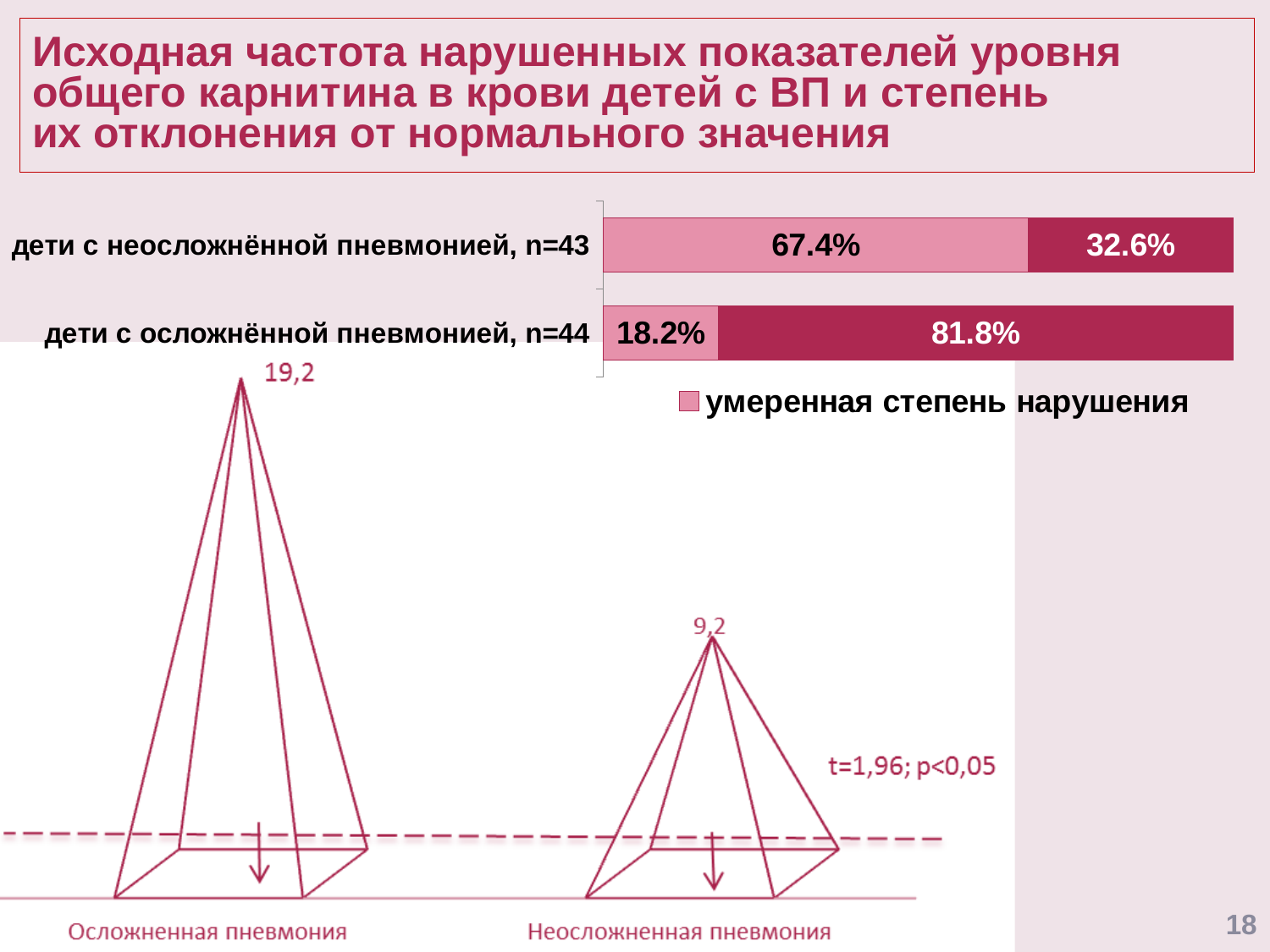
What type of chart is shown at the top right of the slide? stacked bar chart How many categories (groups of children) are shown in the stacked bar chart at the top right? 2 In the pyramid chart at the bottom left, which category has the higher value? Осложненная пневмония In the stacked bar chart at the top right, what is the light-pink value for дети с осложнённой пневмонией, n=44? 18.2% In the stacked bar chart at the top right, what is the dark-red value for дети с осложнённой пневмонией, n=44? 81.8% In the stacked bar chart at the top right, what is the light-pink (умеренная степень нарушения) value for дети с неосложнённой пневмонией, n=43? 67.4% In the stacked bar chart at the top right, which group has the larger light-pink (умеренная степень нарушения) share: n=43 or n=44? дети с неосложнённой пневмонией, n=43 In the pyramid chart at the bottom left, what value is shown for Неосложненная пневмония? 9,2 In the stacked bar chart at the top right, what is the dark-red value for дети с неосложнённой пневмонией, n=43? 32.6% In the stacked bar chart at the top right, what is the difference between the dark-red values of the two groups (81.8% and 32.6%)? 49.2% In the pyramid chart at the bottom left, what value is shown for Осложненная пневмония? 19,2 In the stacked bar chart at the top right, what is the total of the two segments for дети с осложнённой пневмонией, n=44? 100%